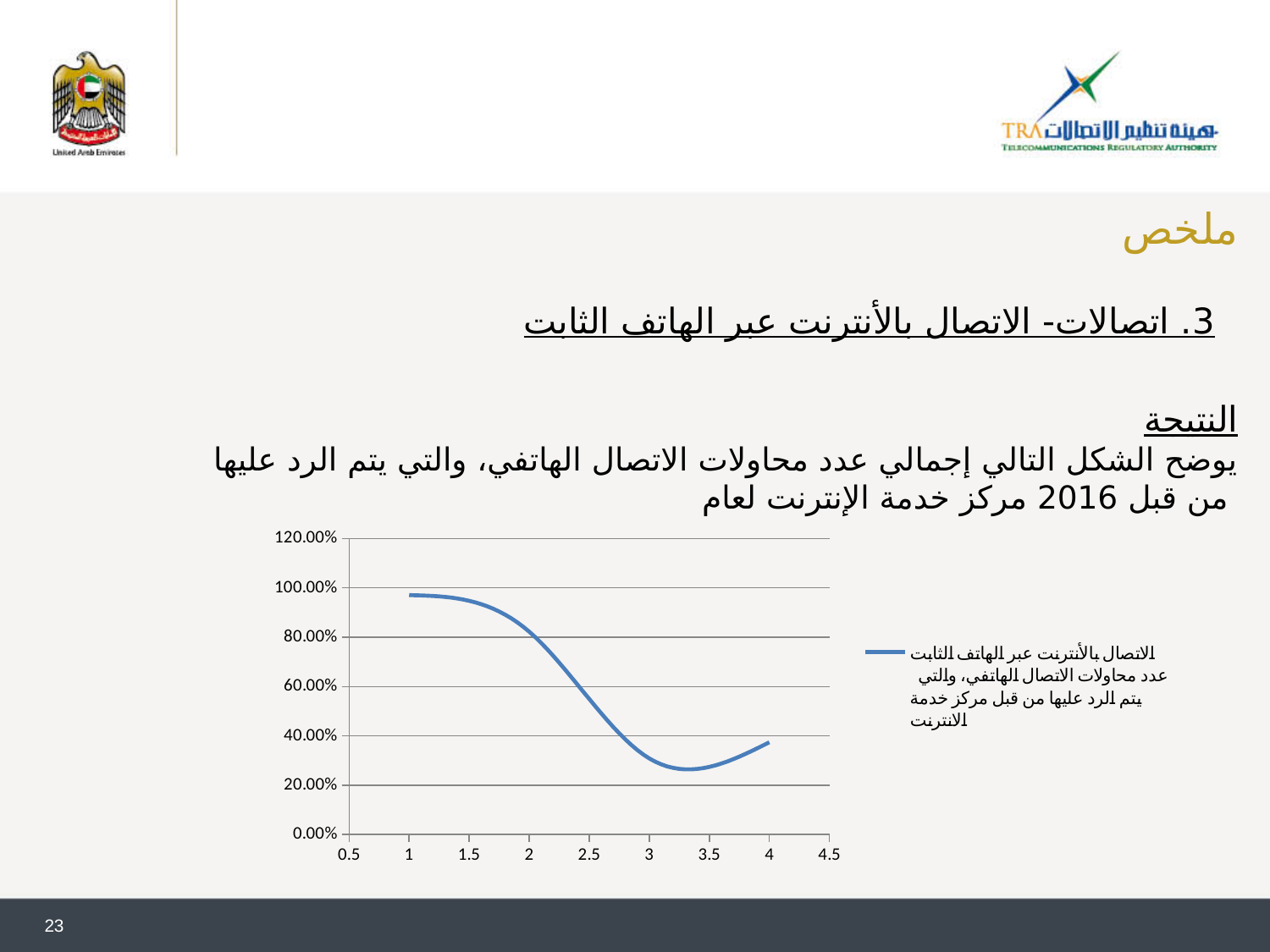
At which x value does the line reach its highest point? 1 Which is larger, the value at x = 1 or the value at x = 3? x = 1 Is the value at x = 1 greater or less than 80.00%? greater Is the value at x = 1 greater or less than 100.00%? less Is the value at x = 3 greater or less than 60.00%? less How many series does the chart's legend list? 1 Does the line rise or fall between x = 1 and x = 3? fall What is the highest value shown on the chart's vertical axis? 120.00% What colour is the line in the chart? blue What kind of chart is shown on the slide? line chart